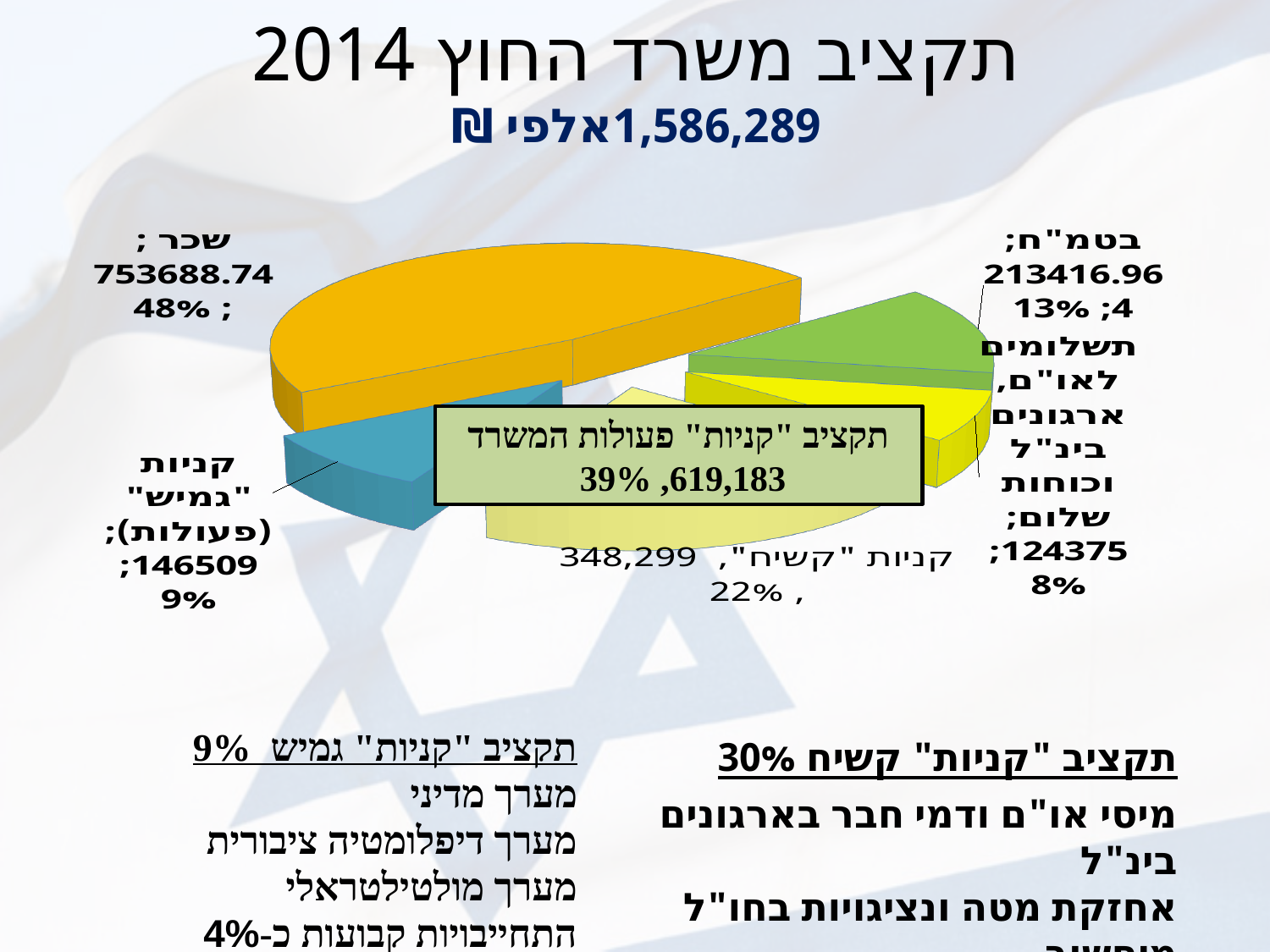
What is the value shown for the בטמ"ח slice? 213416.964 What is the value shown for the שכר slice? 753688.74 Which slice is the smallest in the pie chart? תשלומים לאו"ם, ארגונים בינ"ל וכוחות שלום Which is larger: the בטמ"ח slice or the קניות "גמיש" (פעולות) slice? בטמ"ח What is the value shown for the תשלומים לאו"ם, ארגונים בינ"ל וכוחות שלום slice? 124375 What total budget amount is shown under the chart title? 1,586,289 אלפי ₪ What is the difference in percentage points between the שכר slice (48%) and the קניות "קשיח" slice (22%)? 26% How many slices does the pie chart have? 5 What percentage of the budget does the שכר (salary) slice represent? 48% What percentage is shown for the קניות "קשיח" slice? 22% What kind of chart is shown on the slide? pie chart Which slice is the largest in the pie chart? שכר